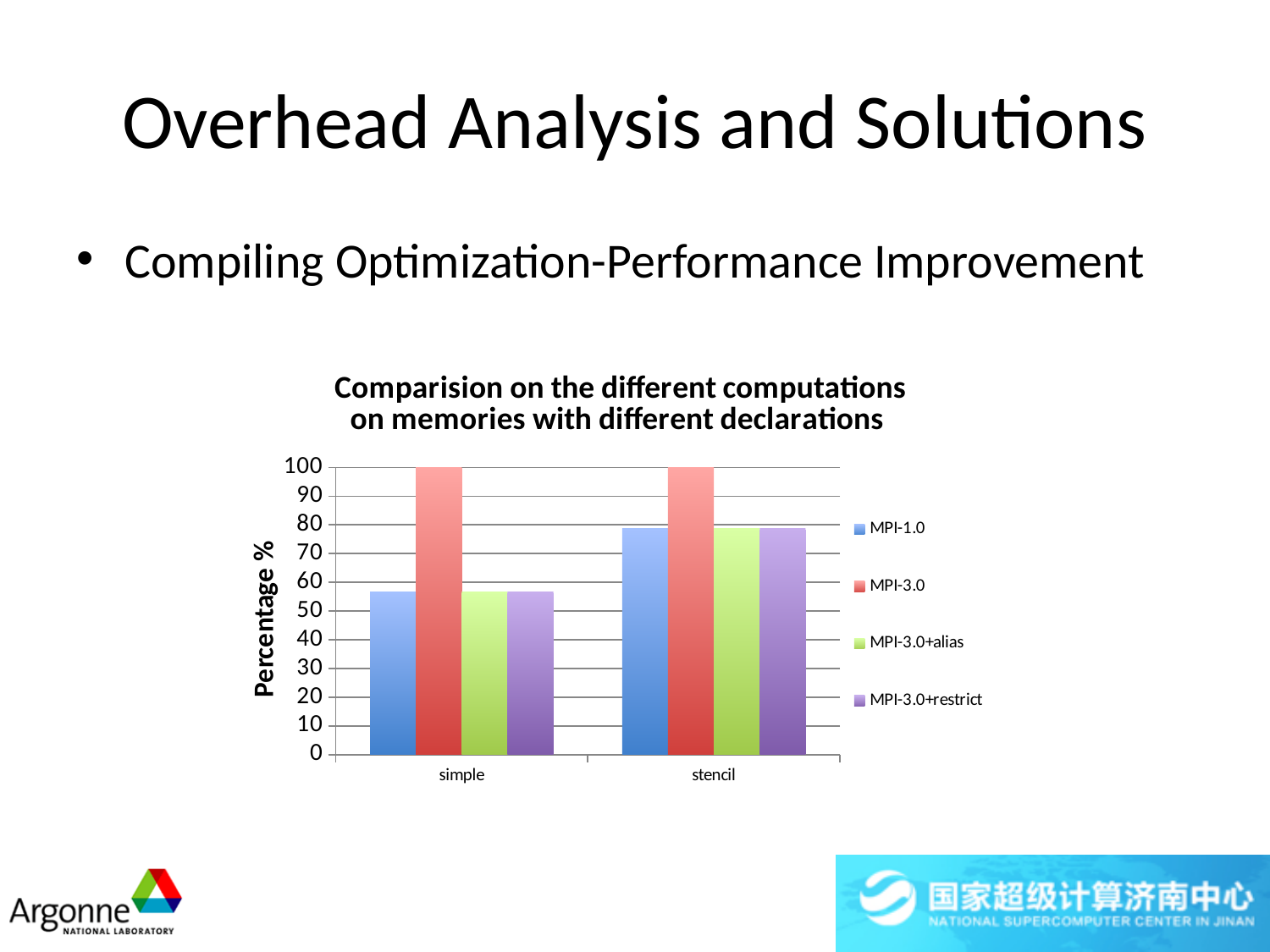
Is the value for MPI-1.0 in the stencil category greater or less than 70? greater Is the value for MPI-3.0+alias in the simple category greater or less than 50? greater What is the label of the y axis? Percentage % What is the value for MPI-3.0 in the simple category? 100 Which series has the highest value in the simple category? MPI-3.0 Is the value for MPI-1.0 in the simple category greater or less than 60? less Which series has the highest value in the stencil category? MPI-3.0 What kind of chart is shown on the slide? bar chart How many categories are shown on the x axis? 2 What is the value for MPI-3.0 in the stencil category? 100 How many series does the legend list? 4 Which is larger, the MPI-3.0+restrict value for simple or for stencil? stencil